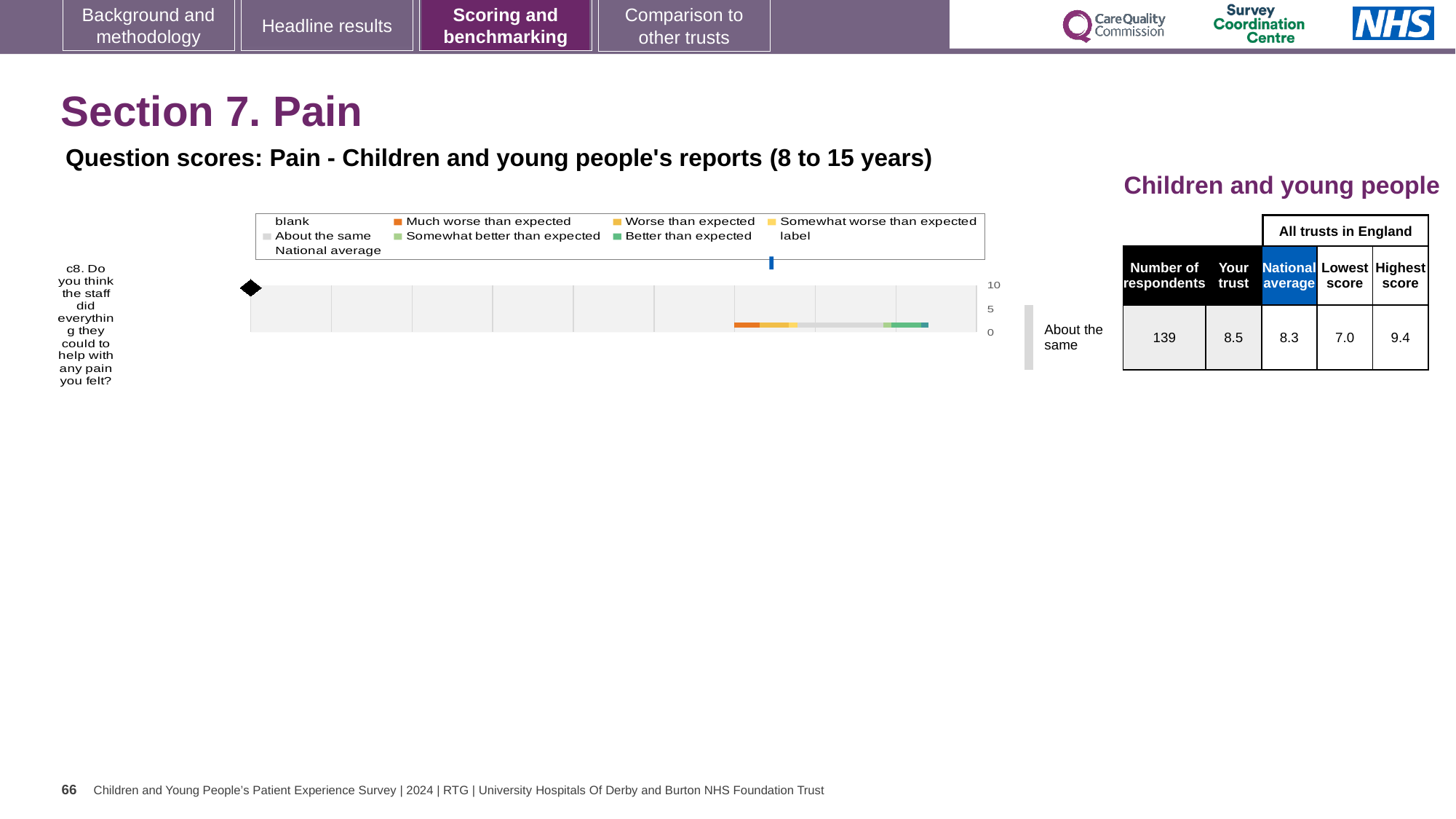
What kind of chart is shown on the slide? bar chart What is the difference between the highest score and the lowest score for question c8? 2.4 What is the 'Your trust' score for question c8? 8.5 What is the lowest score among all trusts in England for question c8? 7.0 Which benchmarking category is the trust's result for question c8 placed in? About the same How many respondents answered question c8? 139 Which is larger for question c8, the 'Your trust' score or the national average? Your trust What is the highest value shown on the chart's numeric axis? 10 What is the difference between the 'Your trust' score and the national average for question c8? 0.2 What is the national average score for question c8? 8.3 What is the highest score among all trusts in England for question c8? 9.4 How many survey questions are plotted in the chart? 1